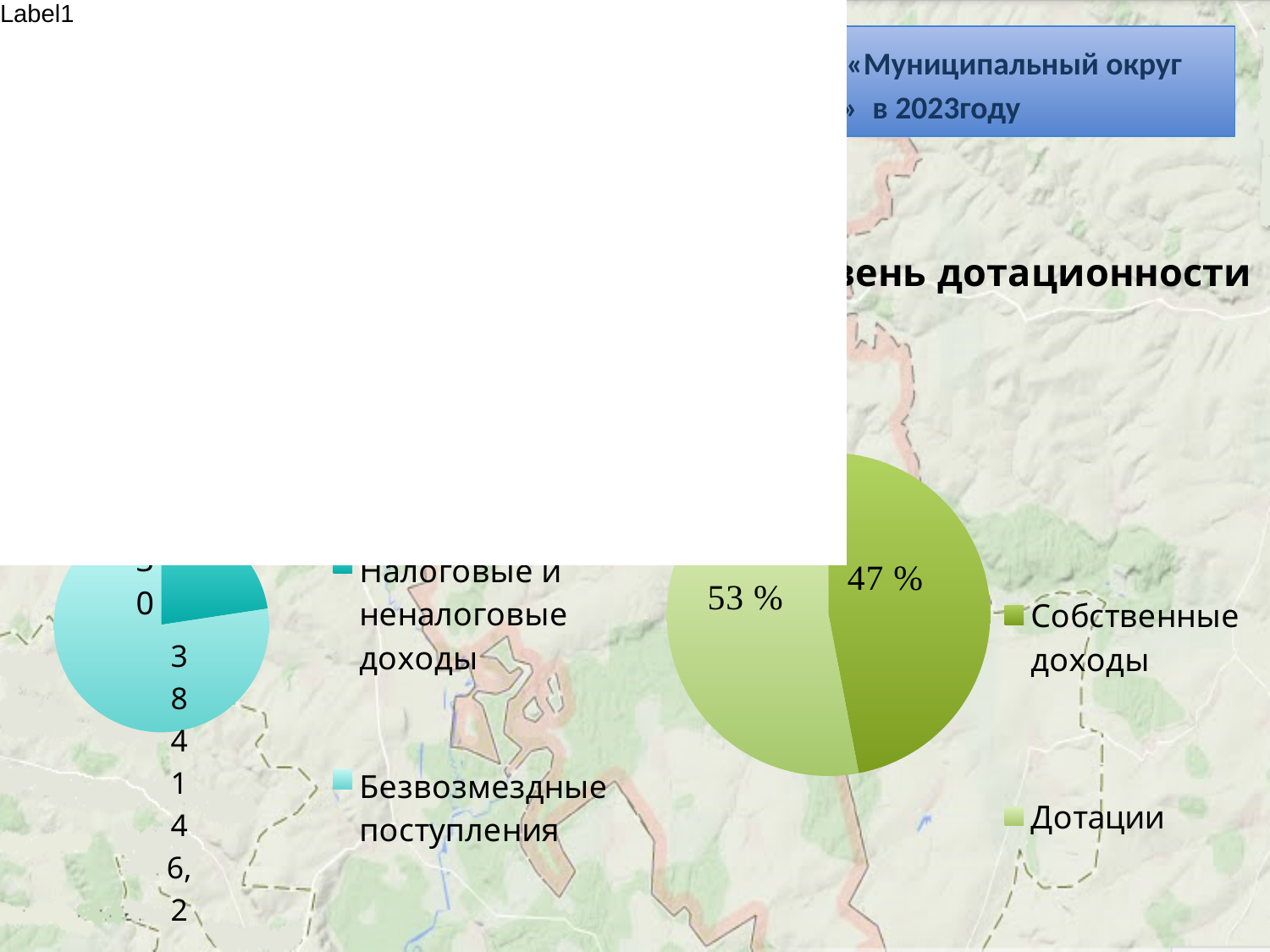
On the right pie chart, which slice is the largest? Дотации What kind of chart is the chart on the right side of the slide? Pie chart On the right pie chart, which is larger: Собственные доходы or Дотации? Дотации On the right pie chart, what is the difference in percentage points between Дотации and Собственные доходы? 6 percentage points On the right pie chart, what share is shown for Собственные доходы? 47 % On the left pie chart, what value is labelled on the Безвозмездные поступления slice? 384146,2 On the left pie chart, which slice is larger: Налоговые и неналоговые доходы or Безвозмездные поступления? Безвозмездные поступления On the right pie chart, what share is shown for Дотации? 53 % How many entries does the legend of the right pie chart list? 2 On the right pie chart, which slice is the smallest? Собственные доходы What kind of chart is the chart on the left side of the slide? Pie chart How many entries does the legend of the left pie chart list? 2